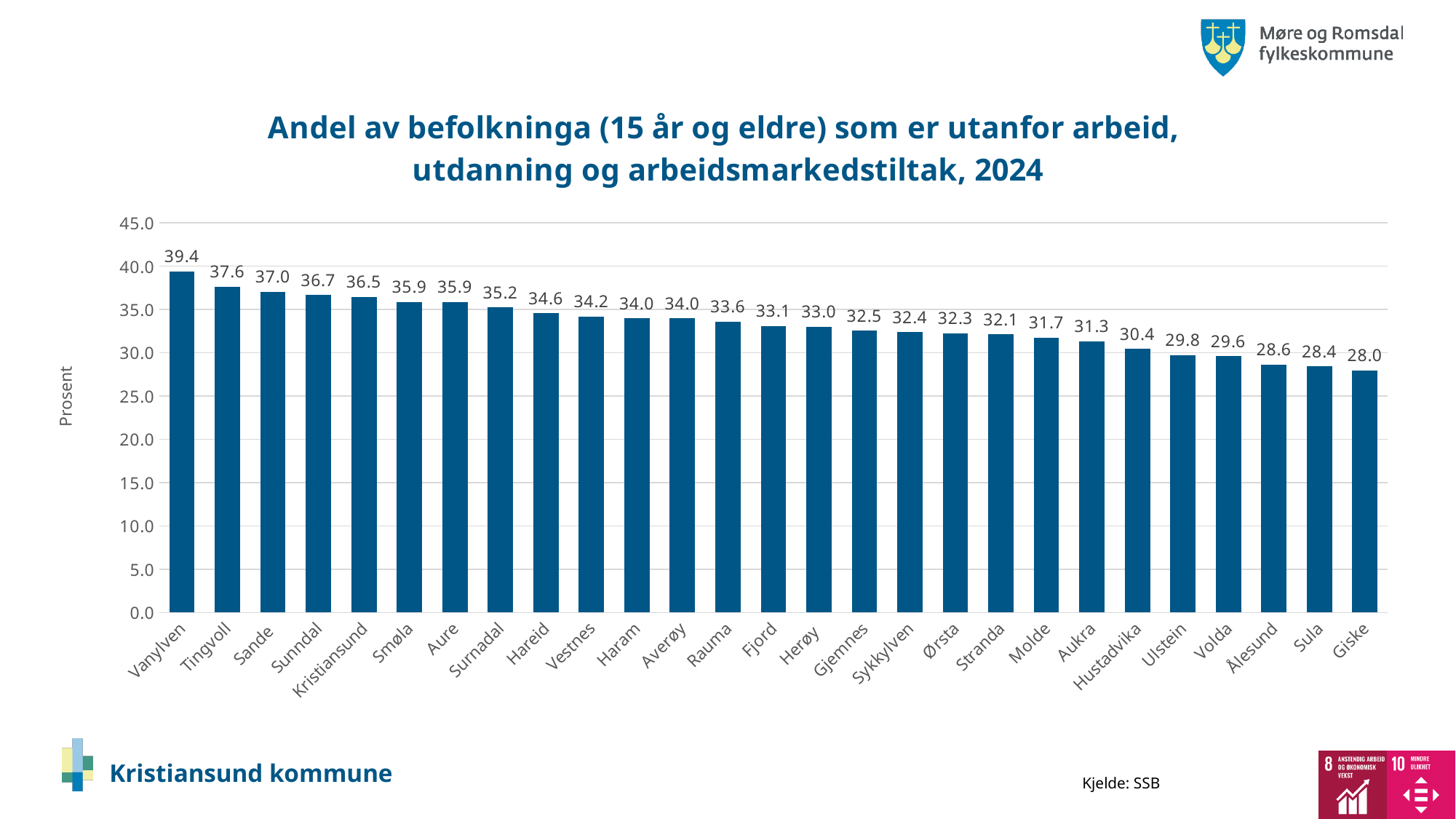
Which municipality has the lowest value? Giske How many municipalities are shown on the chart? 27 What is the value for Molde? 31.7 Which has a larger value, Tingvoll or Sula? Tingvoll What is the value for Ålesund? 28.6 What is the difference between the values for Kristiansund and Molde? 4.8 What is the label on the vertical axis? Prosent Is the value for Hustadvika greater or less than 35.0? less What kind of chart is shown on the slide? bar chart What is the value for Kristiansund? 36.5 Which municipality has the highest value? Vanylven What is the difference between the values for Vanylven and Giske? 11.4